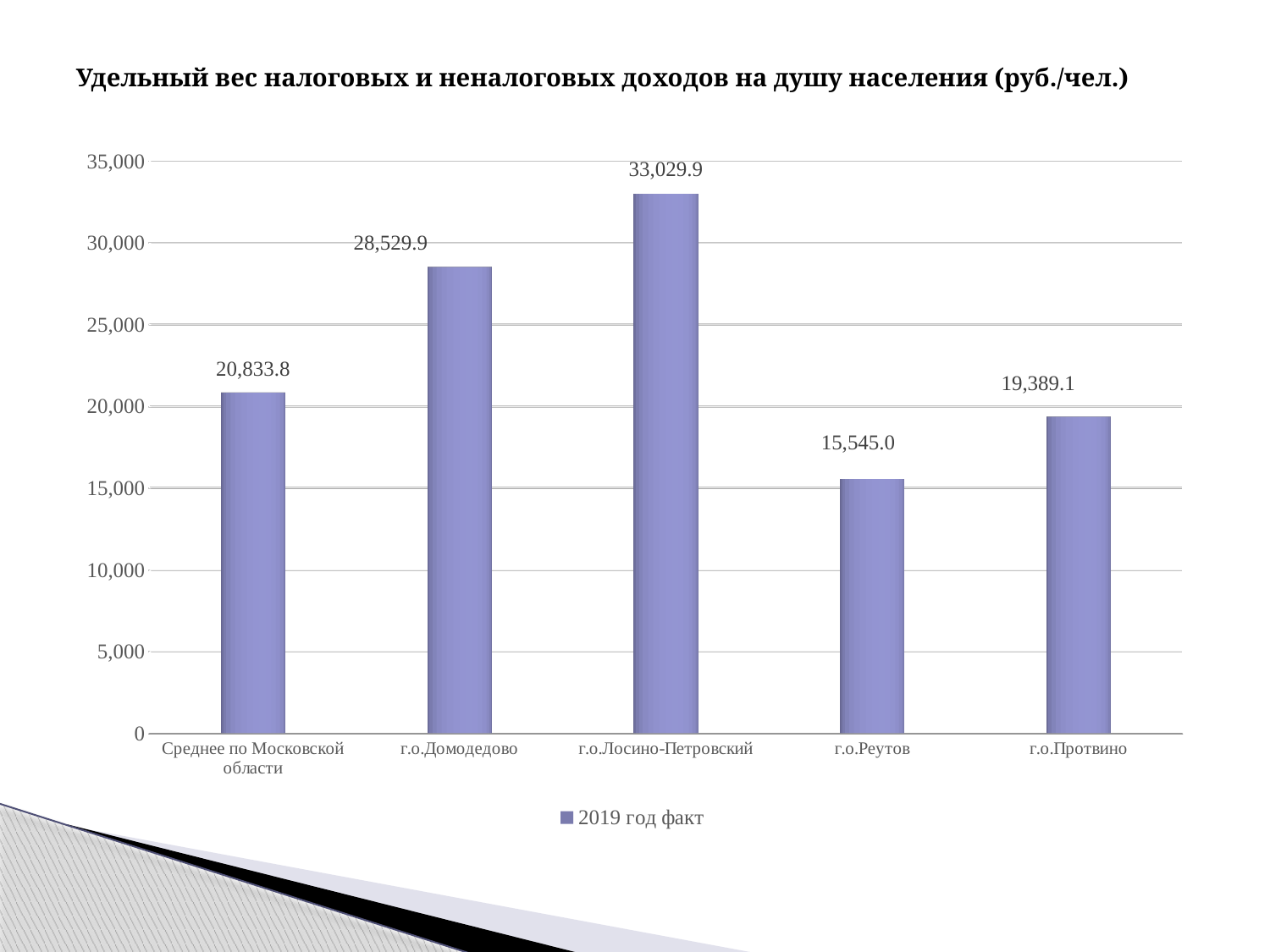
What is the value for г.о.Домодедово? 28,529.9 Which is larger, the value for г.о.Протвино or the value for Среднее по Московской области? Среднее по Московской области What kind of chart is shown on the slide? bar chart What is the difference between the values for Среднее по Московской области and г.о.Реутов? 5,288.8 Which category has the lowest value? г.о.Реутов What is the difference between the values for г.о.Лосино-Петровский and г.о.Домодедово? 4,500.0 What is the value for Среднее по Московской области? 20,833.8 What is the value for г.о.Протвино? 19,389.1 Which category has the highest value? г.о.Лосино-Петровский What series name does the legend show? 2019 год факт How many categories are shown on the x axis? 5 What is the value for г.о.Реутов? 15,545.0